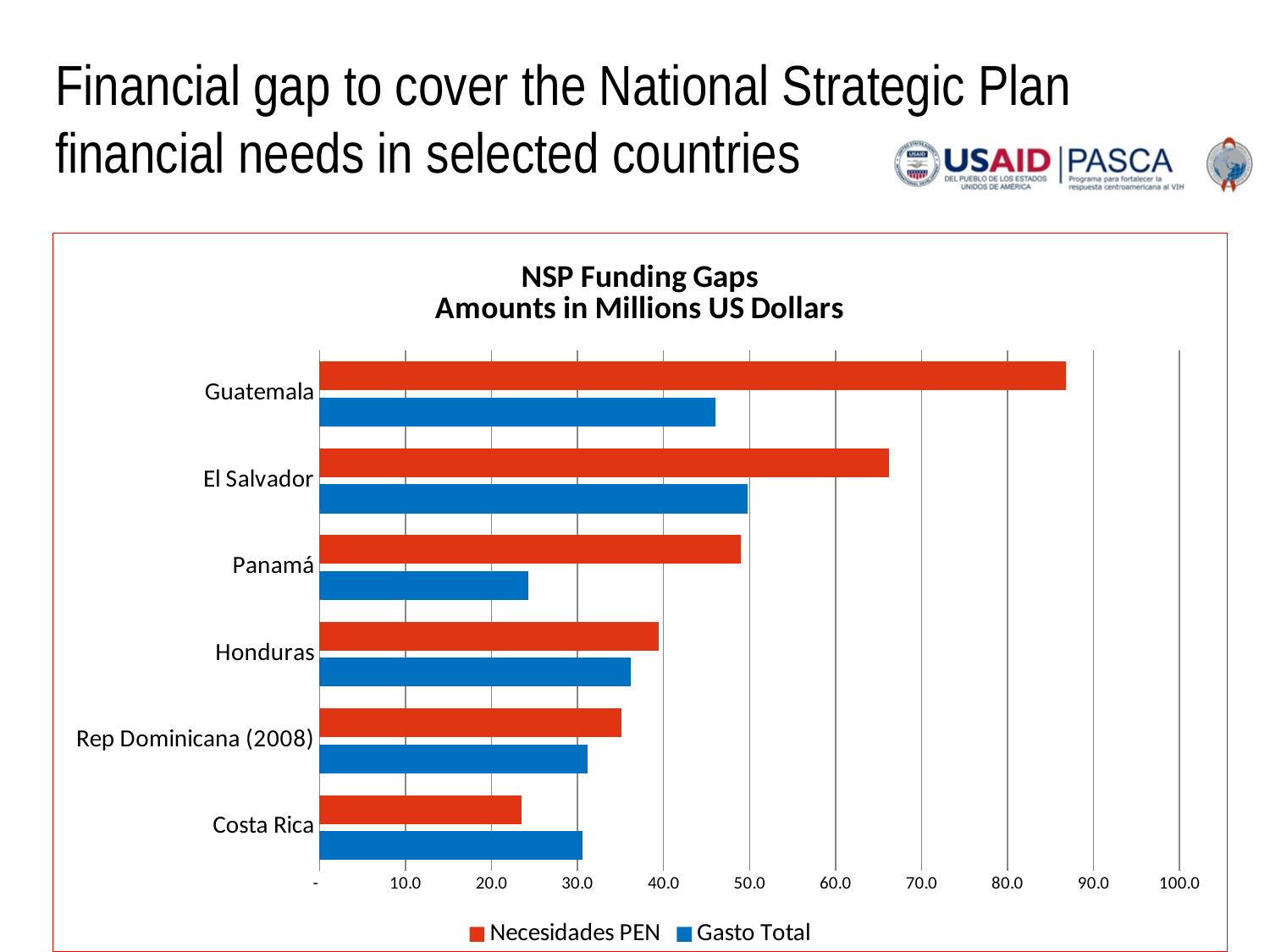
What is the title of the chart? NSP Funding Gaps Amounts in Millions US Dollars Is the Necesidades PEN value for El Salvador greater or less than 60.0? greater Which country has the lowest Necesidades PEN value? Costa Rica Which country has the highest Necesidades PEN value? Guatemala Is the Necesidades PEN value for Guatemala greater or less than 80.0? greater Is the Necesidades PEN value for Costa Rica greater or less than 30.0? less What kind of chart is shown on the slide? bar chart Which country has the lowest Gasto Total value? Panamá How many series does the legend list? 2 How many countries are shown on the chart? 6 For Costa Rica, which is larger: Necesidades PEN or Gasto Total? Gasto Total